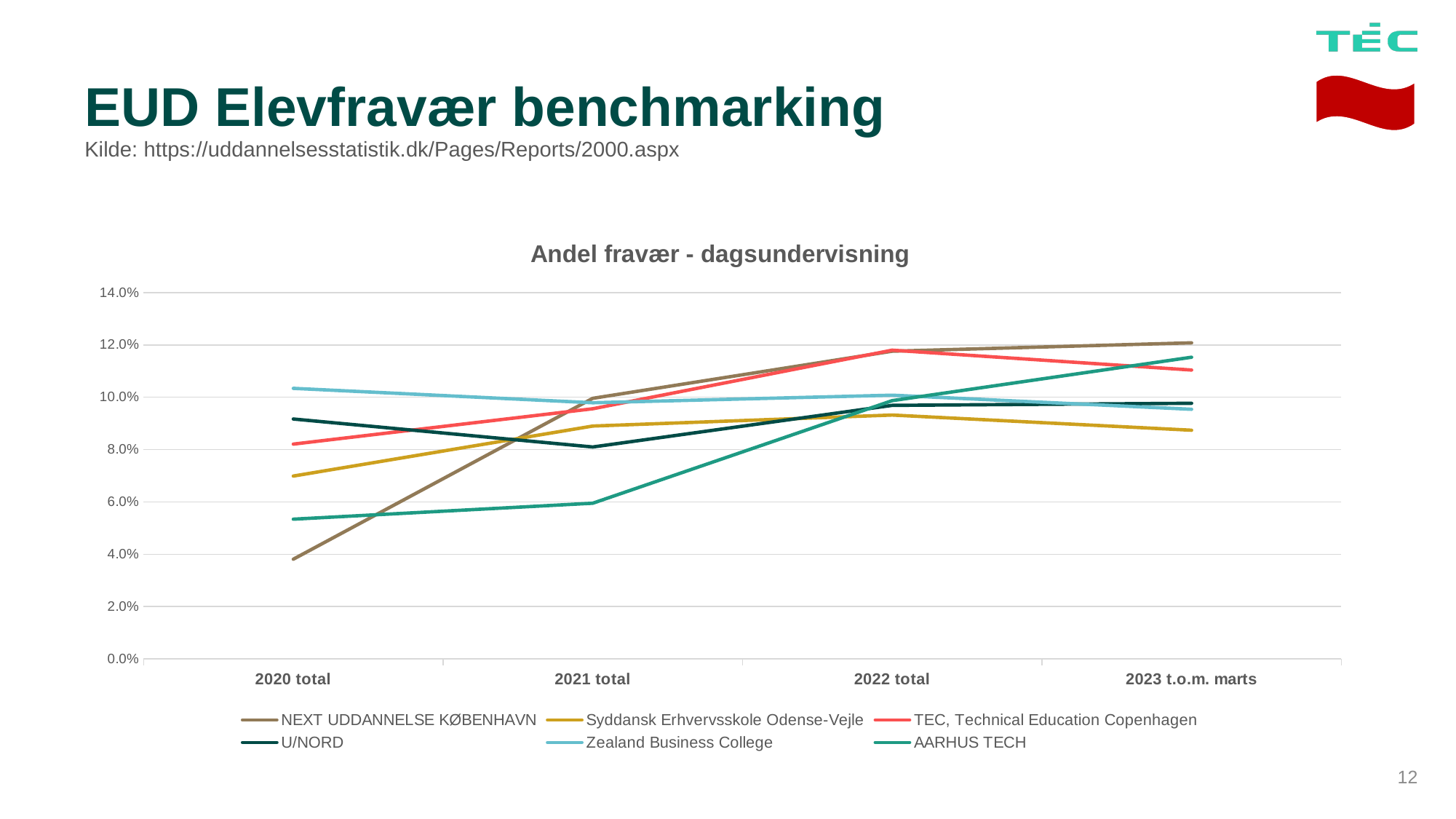
What kind of chart is shown on the slide? line chart Which school has the highest value for 2020 total? Zealand Business College Does the line for NEXT UDDANNELSE KØBENHAVN rise or fall from 2020 total to 2023 t.o.m. marts? rises Which school has the lowest value for 2020 total? NEXT UDDANNELSE KØBENHAVN How many points are shown along the x axis? 4 Is the value for NEXT UDDANNELSE KØBENHAVN in 2020 total greater or less than 6.0%? less Which school has the highest value for 2023 t.o.m. marts? NEXT UDDANNELSE KØBENHAVN How many series does the legend list? 6 Is the value for TEC, Technical Education Copenhagen in 2022 total greater or less than 10.0%? greater Which school has the lowest value for 2023 t.o.m. marts? Syddansk Erhvervsskole Odense-Vejle Is the value for AARHUS TECH in 2021 total greater or less than 8.0%? less In 2021 total, which is larger: NEXT UDDANNELSE KØBENHAVN or AARHUS TECH? NEXT UDDANNELSE KØBENHAVN